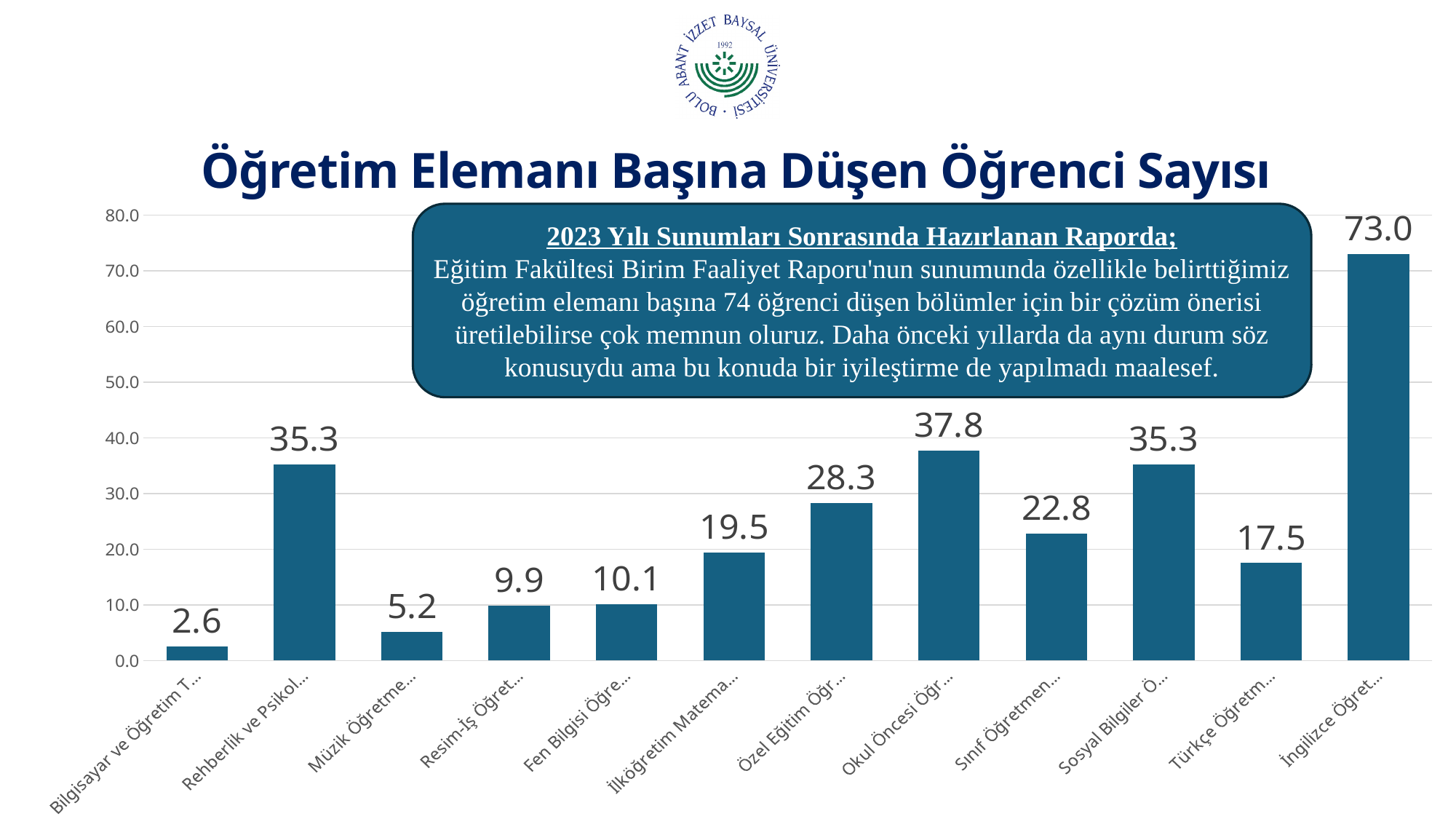
Which category has the lowest value? Bilgisayar ve Öğretim T... Which category has the highest value? İngilizce Öğret... What is the value for the Müzik Öğretme... category? 5.2 How many bars (categories) are plotted in the chart? 12 What is the title of the chart? Öğretim Elemanı Başına Düşen Öğrenci Sayısı What is the value for the Okul Öncesi Öğr... category? 37.8 What is the difference between the values for Fen Bilgisi Öğre... and Resim-İş Öğret...? 0.2 What is the difference between the values for İngilizce Öğret... and Okul Öncesi Öğr...? 35.2 Which is larger, the value for Özel Eğitim Öğr... or the value for Sınıf Öğretmen...? Özel Eğitim Öğr... What type of chart is shown on the slide? Bar chart Is the value for Sosyal Bilgiler Ö... greater or less than 30.0? greater What is the value for the İngilizce Öğret... category? 73.0